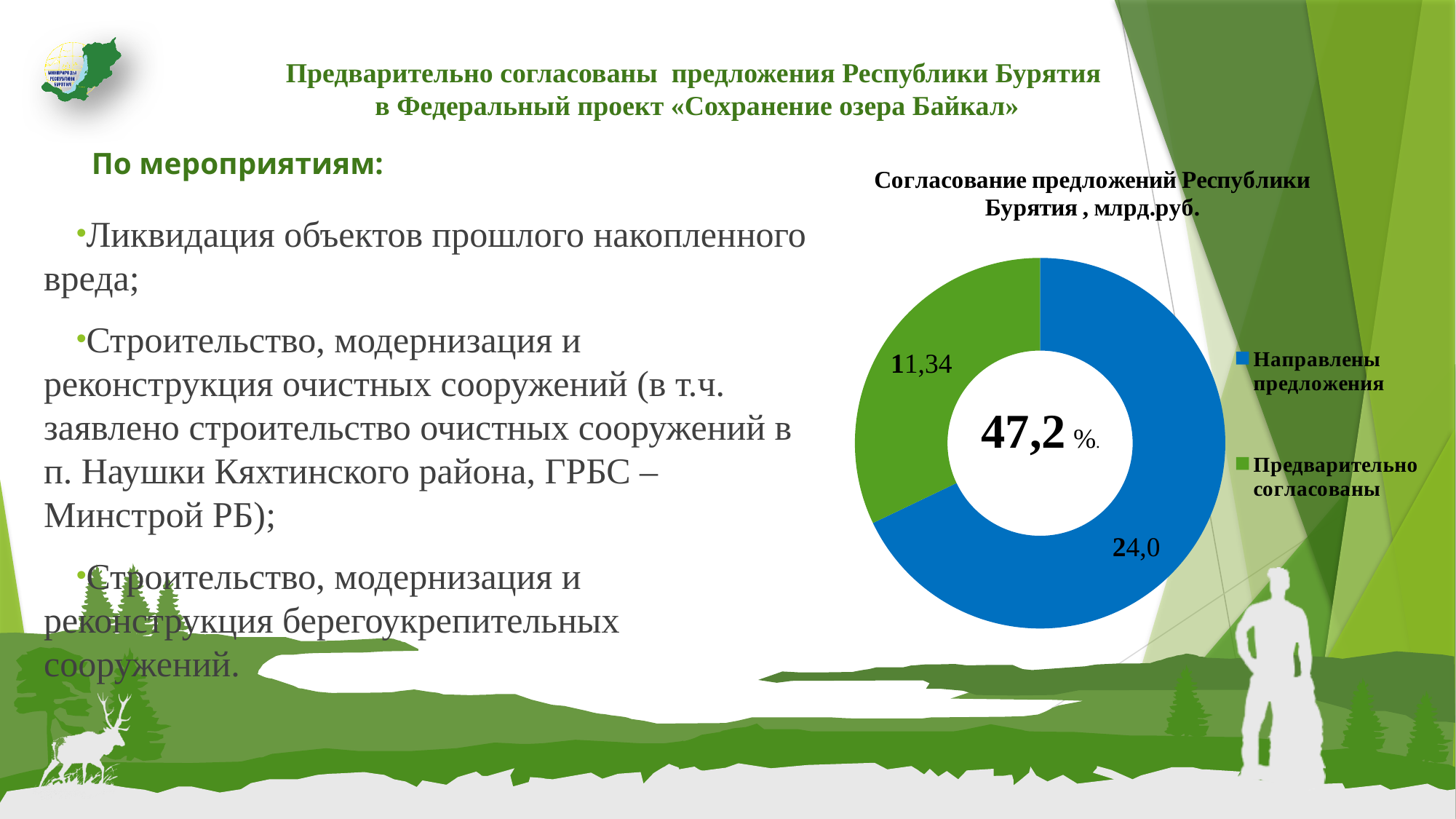
Which is larger: the value for "Направлены предложения" or for "Предварительно согласованы"? Направлены предложения How many categories (slices) does the chart contain? 2 What type of chart is shown on the slide? Doughnut (pie) chart How many entries does the chart legend list? 2 What is the total of the two values shown in the chart? 35,34 What colour is the slice for "Предварительно согласованы"? Green Which category has the smallest slice in the chart? Предварительно согласованы What percentage is printed in the centre of the doughnut chart? 47,2 % What value is shown for "Предварительно согласованы" in the chart? 11,34 What is the difference between the values for "Направлены предложения" and "Предварительно согласованы"? 12,66 Which category has the largest slice in the chart? Направлены предложения What value is shown for "Направлены предложения" in the chart "Согласование предложений Республики Бурятия, млрд.руб."? 24,0